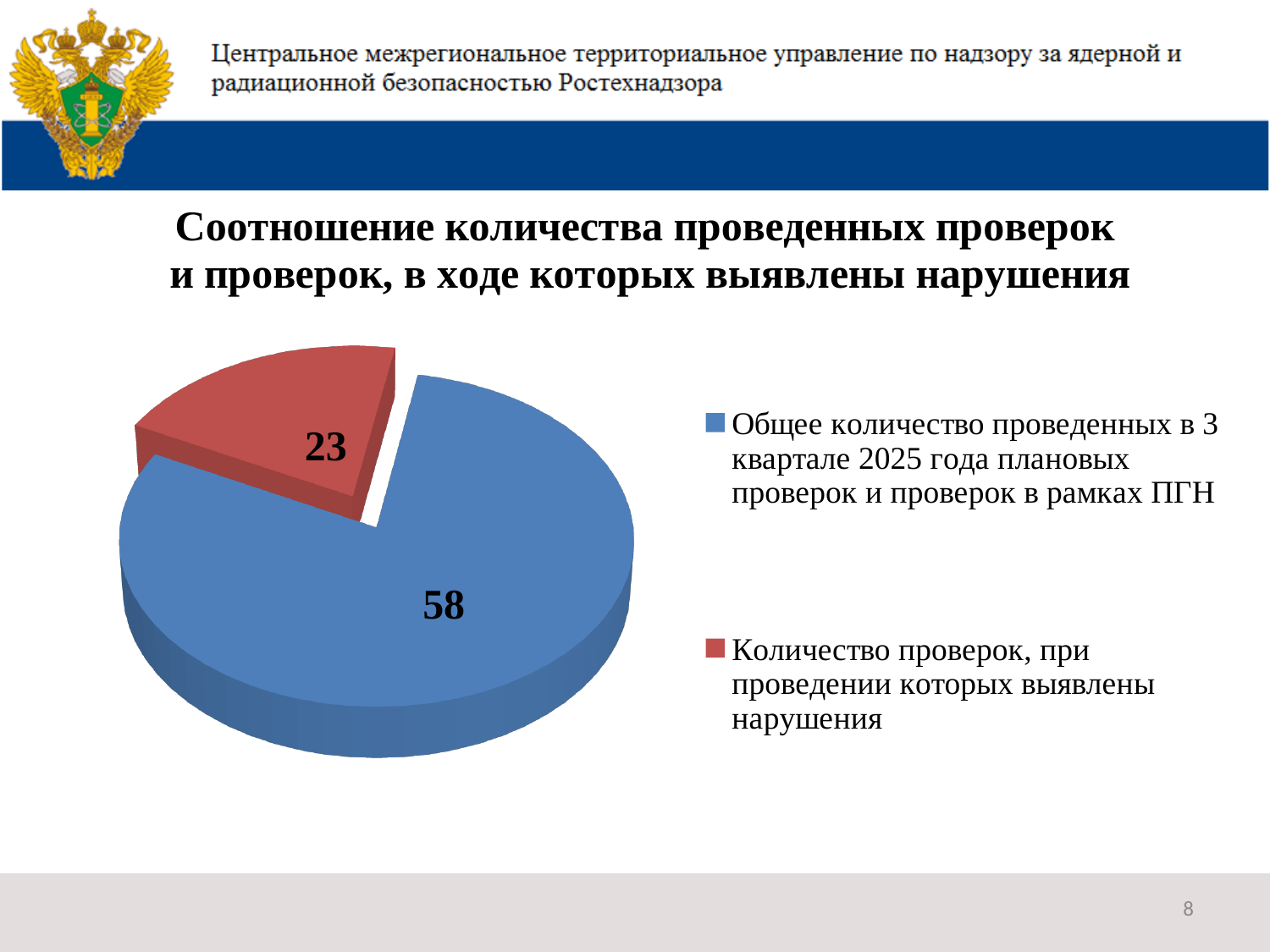
What is the value of the slice for "Общее количество проведенных в 3 квартале 2025 года плановых проверок и проверок в рамках ПГН"? 58 Which slice of the pie chart is the largest? Общее количество проведенных в 3 квартале 2025 года плановых проверок и проверок в рамках ПГН What is the difference between the value of the blue slice and the value of the red slice? 35 What type of chart is shown on the slide? Pie chart Which is larger: the value for total inspections conducted (blue slice) or the value for inspections with violations found (red slice)? Total inspections conducted (blue slice) What colour is the slice labelled 23? Red What is the title of the chart on the slide? Соотношение количества проведенных проверок и проверок, в ходе которых выявлены нарушения How many slices does the pie chart have? 2 What is the value of the slice for "Количество проверок, при проведении которых выявлены нарушения"? 23 Which slice of the pie chart is the smallest? Количество проверок, при проведении которых выявлены нарушения What is the sum of the two values shown on the pie chart? 81 How many entries does the legend list? 2